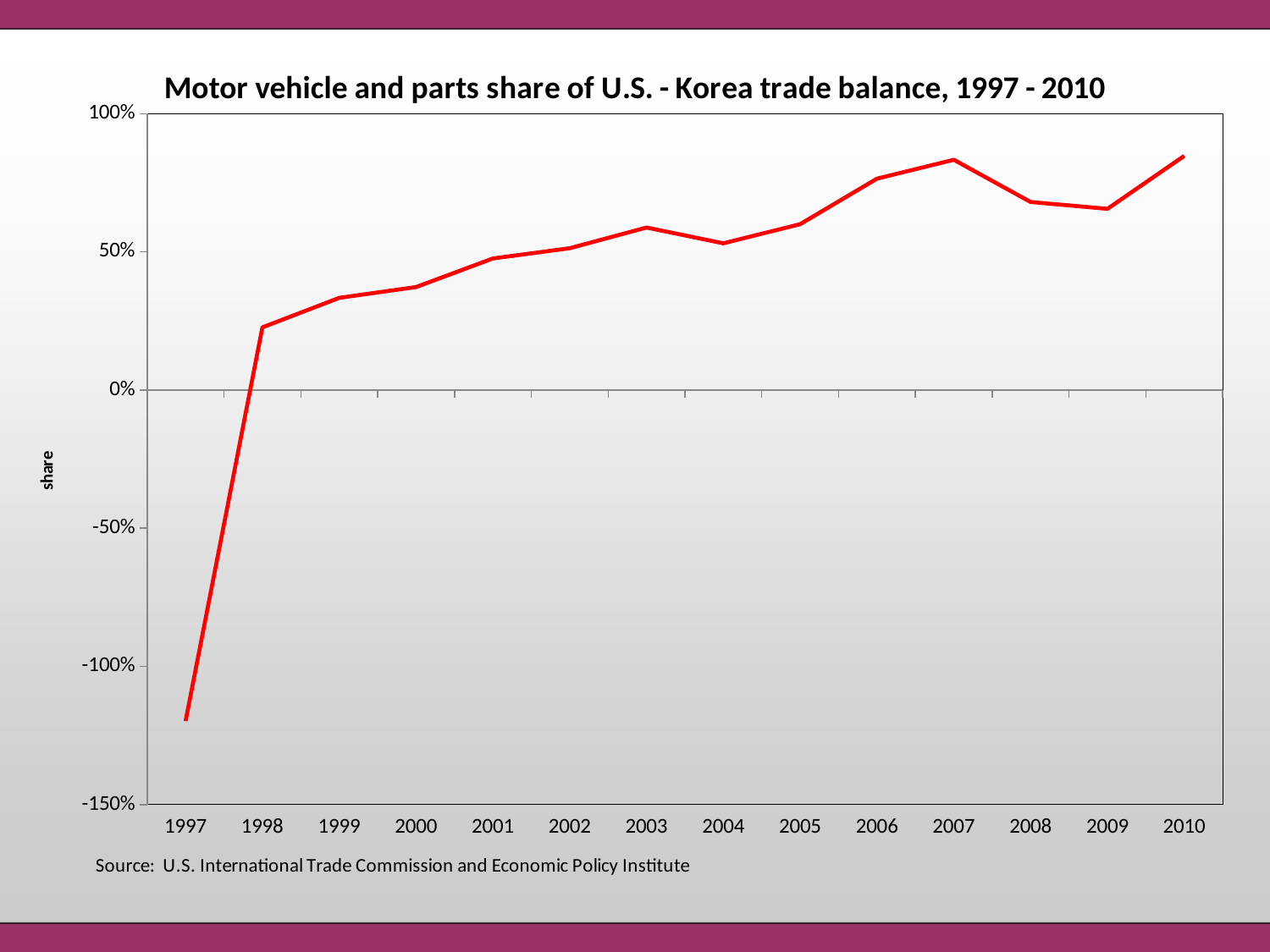
Which year has the larger value, 2007 or 2008? 2007 What is the label on the vertical axis? share How many years are plotted along the x axis? 14 Is the value for 1998 greater or less than 50%? less Which year has the lowest motor vehicle and parts share of the U.S.-Korea trade balance? 1997 Is the value for 2000 greater or less than 50%? less Is the value for 1997 greater or less than -100%? less What is the title of the chart? Motor vehicle and parts share of U.S. - Korea trade balance, 1997 - 2010 Which year has the larger value, 2005 or 2006? 2006 Overall, does the share rise or fall from 1997 to 2010? rise What kind of chart is shown on the slide? line chart